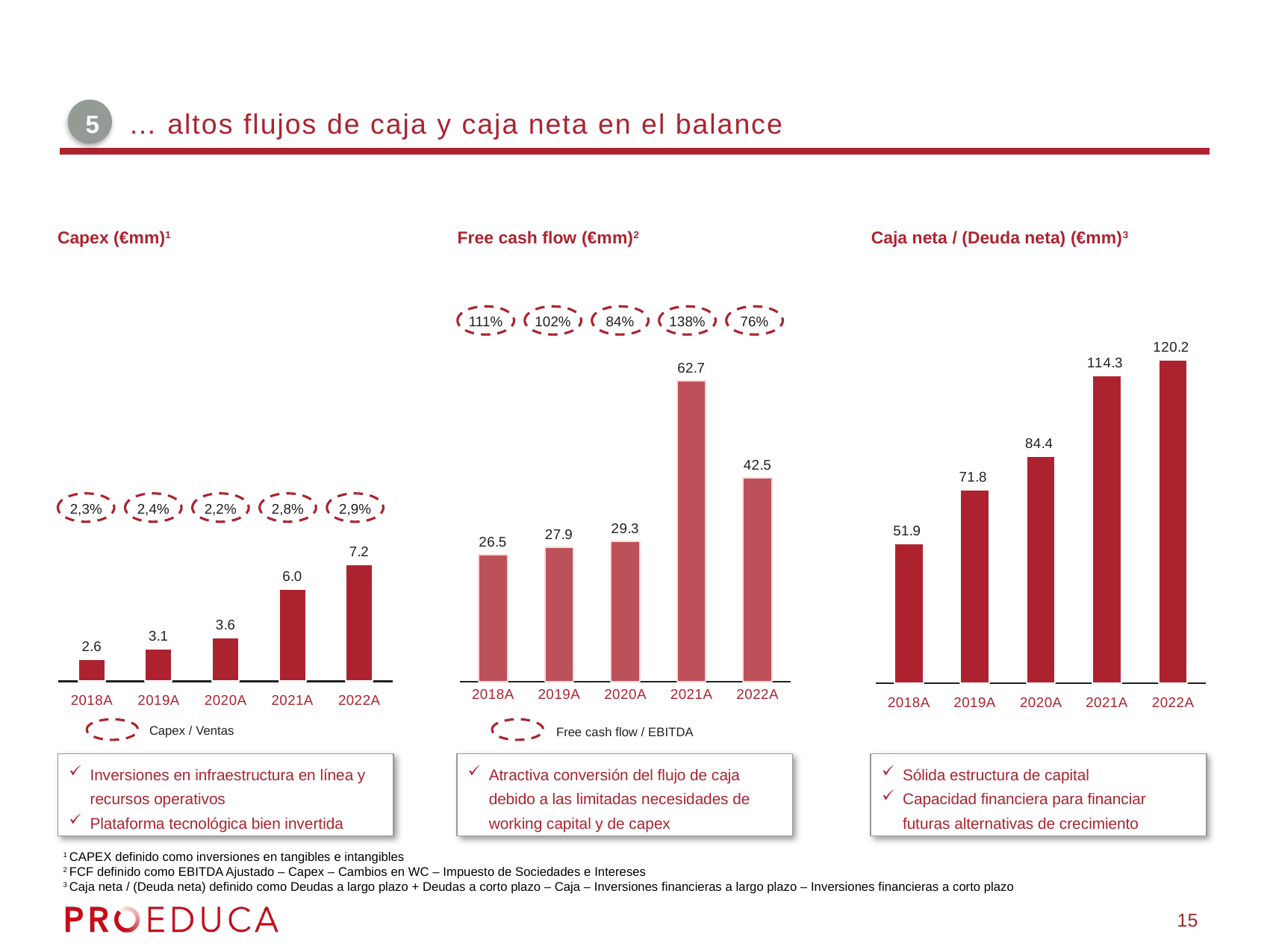
In the Caja neta / (Deuda neta) (€mm) chart, which year has the lowest value? 2018A In the Free cash flow (€mm) chart, what is the difference between the 2021A and 2022A values? 20.2 What type of chart is the Caja neta / (Deuda neta) (€mm) chart? bar chart In the Caja neta / (Deuda neta) (€mm) chart, do the values rise or fall from 2018A to 2022A? rise How many years are shown on the x axis of the Capex (€mm) chart? 5 In the Capex (€mm) chart, what is the value for 2020A? 3.6 In the Capex (€mm) chart, what is the Capex / Ventas ratio shown for 2021A? 2,8% In the Free cash flow (€mm) chart, what is the Free cash flow / EBITDA ratio shown for 2022A? 76% In the Free cash flow (€mm) chart, which year has the highest value? 2021A In the Caja neta / (Deuda neta) (€mm) chart, what is the value for 2018A? 51.9 In the Free cash flow (€mm) chart, what is the value for 2019A? 27.9 In the Capex (€mm) chart, which is larger, the value for 2019A or the value for 2021A? 2021A